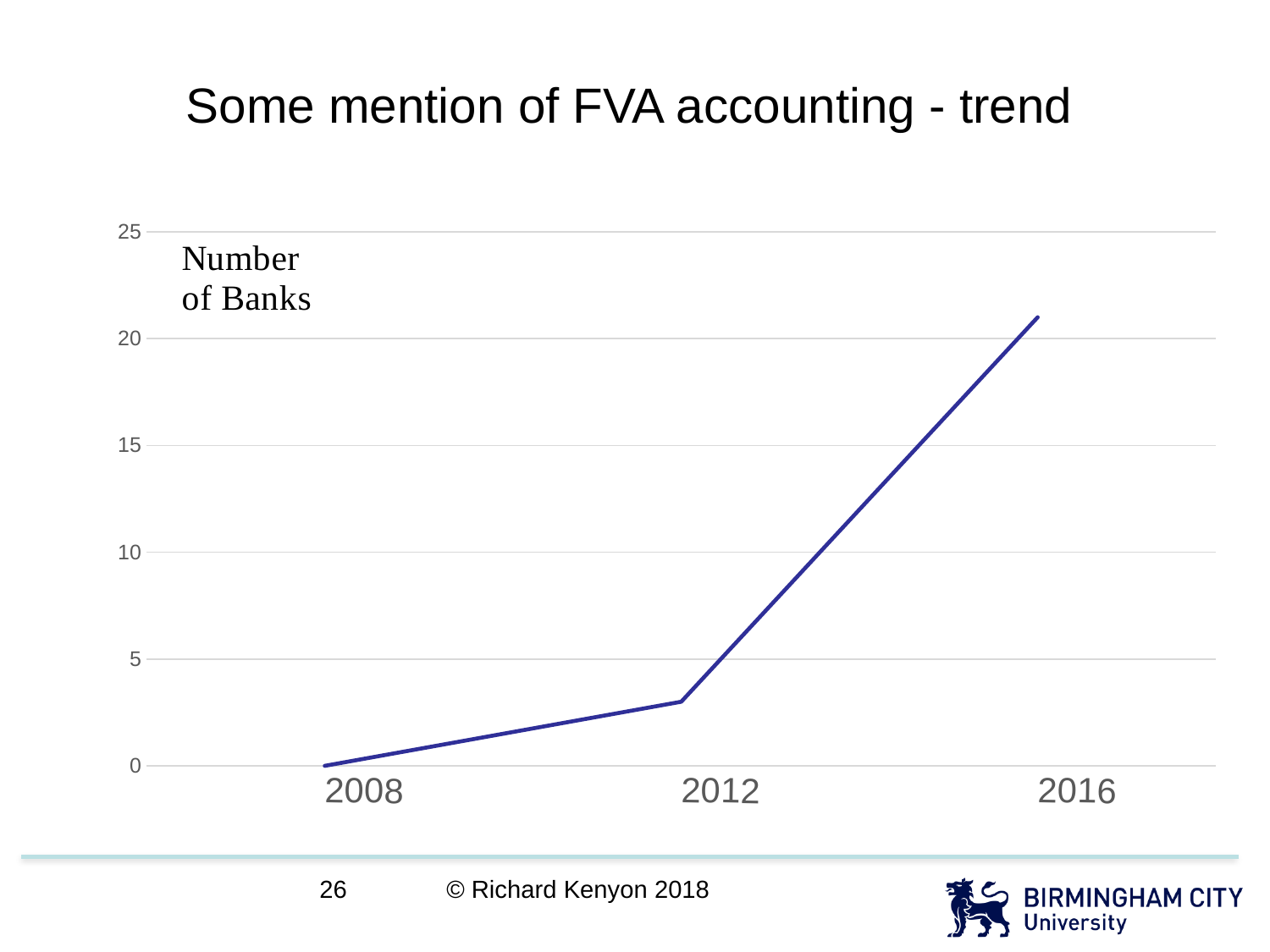
Do the values rise or fall from 2008 to 2016? rise What kind of chart is shown on the slide? line chart What is the number of banks for 2008? 0 Is the value for 2012 greater or less than 5? less Which year has the lowest number of banks? 2008 How many years are plotted on the x axis of the chart? 3 Is the value for 2016 greater or less than 15? greater Which year has the larger number of banks, 2012 or 2016? 2016 What does the vertical axis of the chart measure, according to the label on the chart? Number of Banks Which year has the highest number of banks? 2016 What is the title of the chart? Some mention of FVA accounting - trend Is the value for 2016 greater or less than 20? greater